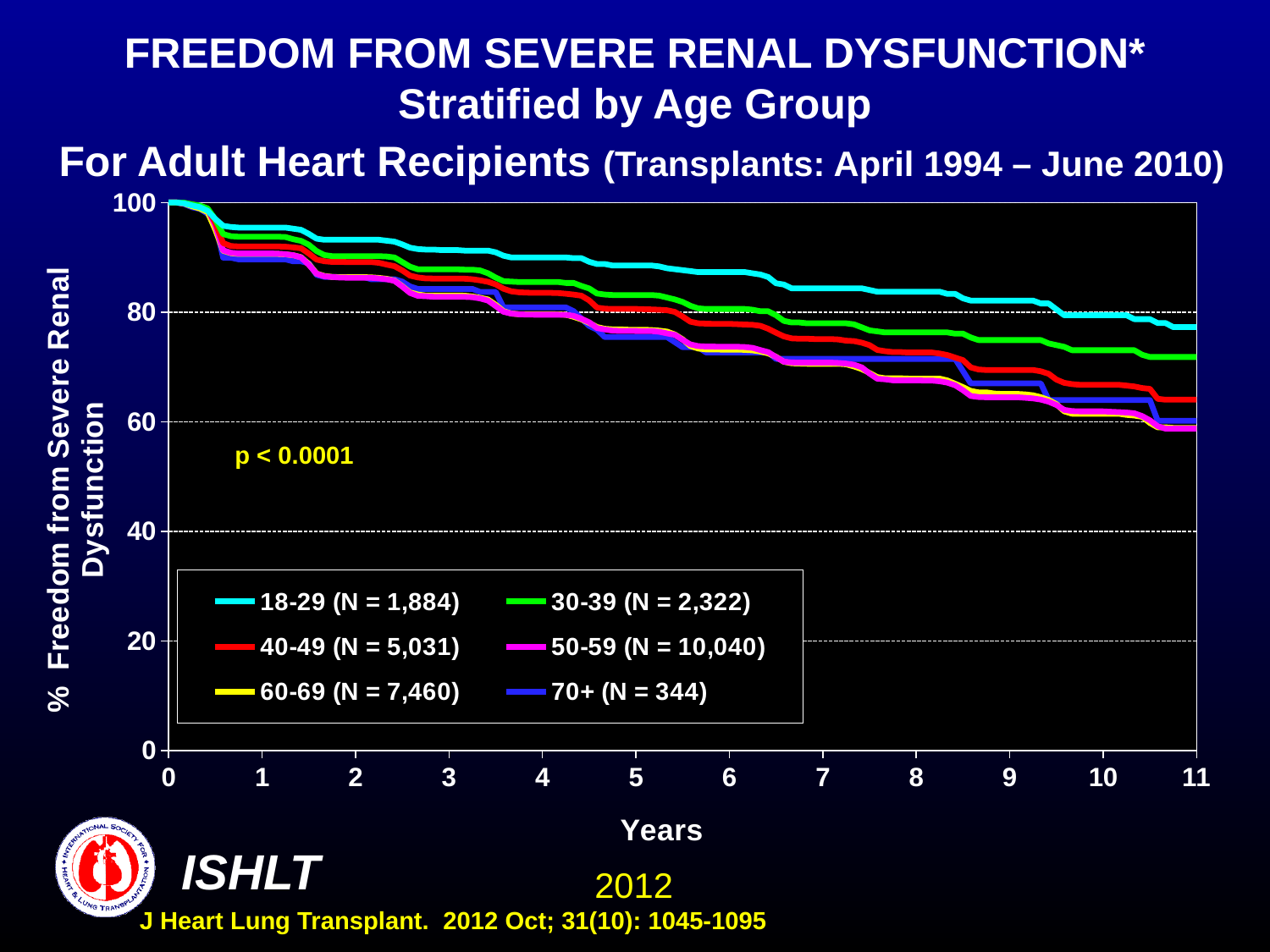
Do the curves rise or fall as the number of years increases? fall Which age group has the highest % freedom from severe renal dysfunction at 11 years? 18-29 What kind of chart is shown on the slide? line chart How many series does the legend list? 6 Is the value for the 50-59 group at 11 years greater or less than 80? less Is the value for the 30-39 group at 11 years greater or less than 80? less What is the % freedom from severe renal dysfunction for all groups at year 0? 100 What p-value is printed on the chart? p < 0.0001 At 11 years, which is higher: the 18-29 group or the 50-59 group? 18-29 Is the value for the 18-29 group at 11 years greater or less than 60? greater At 11 years, which is higher: the 30-39 group or the 40-49 group? 30-39 According to the legend, what is N for the 50-59 age group? 10,040